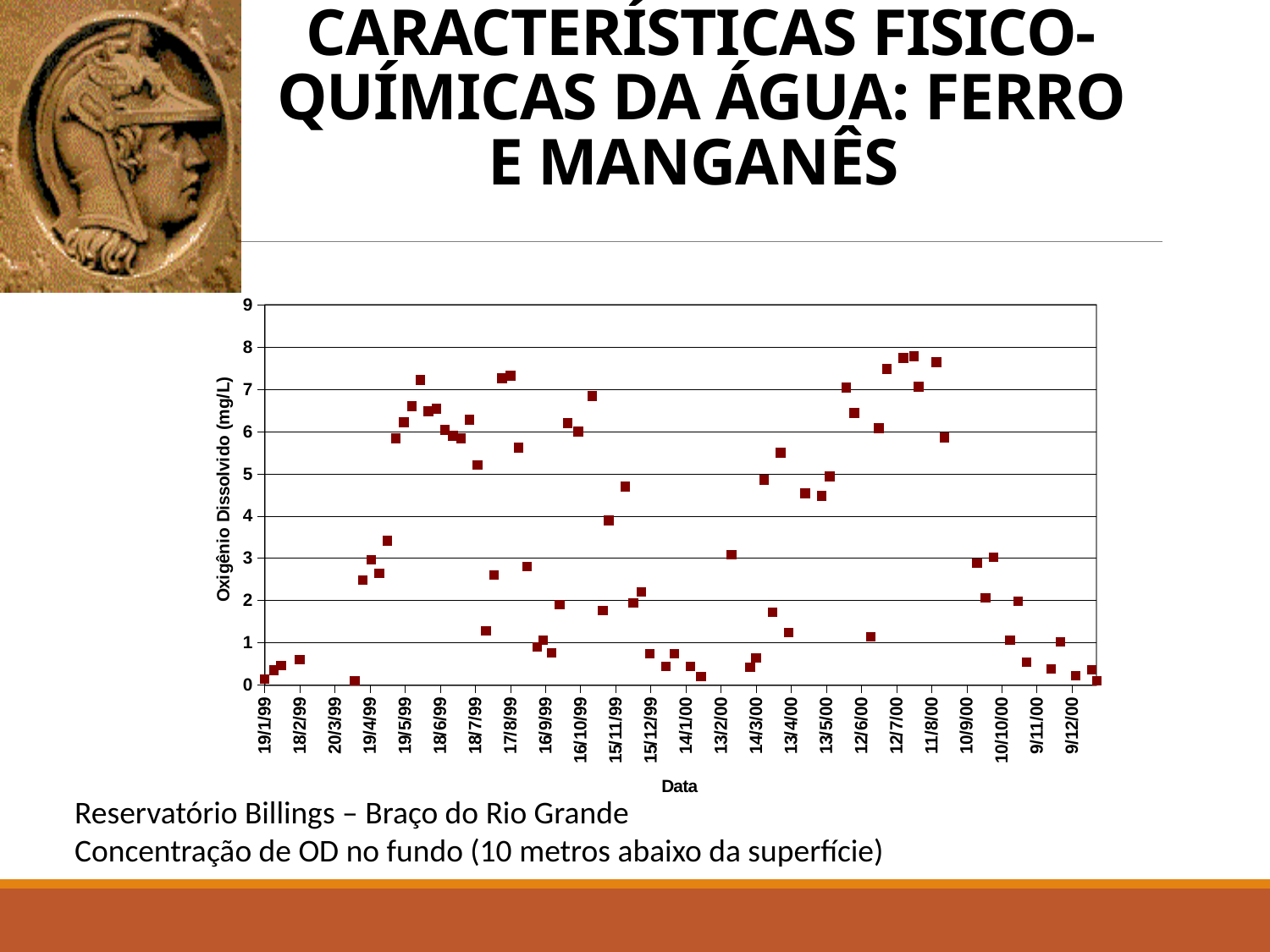
How many date labels are printed along the horizontal axis of the chart? 24 What is the label of the vertical axis of the chart? Oxigênio Dissolvido (mg/L) Do the values generally rise or fall between 19/1/99 and 19/5/99? rise Which is larger: the value at the 19/1/99 tick or the value at the 15/11/99 tick? 15/11/99 What is the label of the horizontal axis of the chart? Data What is the highest value shown on the vertical axis of the chart? 9 What kind of chart is shown on the slide? scatter chart Is the highest point on the chart, near 12/7/00, greater or less than 7? greater Do the values generally rise or fall between 12/7/00 and 9/12/00? fall Is the point plotted at the 15/11/99 tick greater or less than 3? greater Is the value of the first point, at 19/1/99, greater or less than 1? less